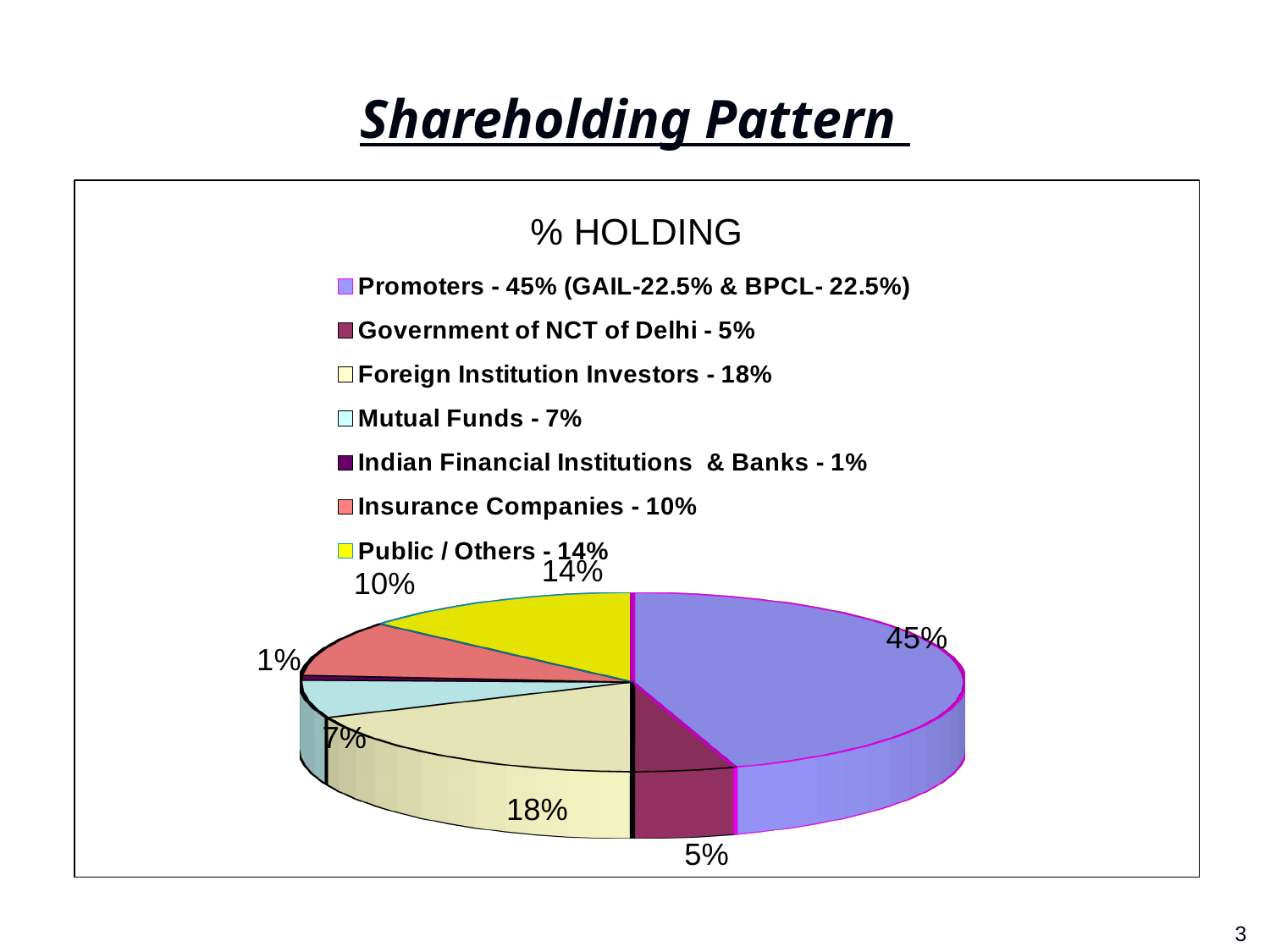
What kind of chart is shown on the slide? pie chart What is the holding of Government of NCT of Delhi? 5% Which is larger, the share of Public / Others or the share of Insurance Companies? Public / Others Which category has the largest share of the pie? Promoters What is the holding of Mutual Funds? 7% What percentage of holding do Promoters have? 45% What is the chart's title? % HOLDING What is the holding of Insurance Companies? 10% What is the difference between the Promoters' share and the Foreign Institution Investors' share? 27% Which category has the smallest share of the pie? Indian Financial Institutions & Banks What is the holding of Foreign Institution Investors? 18% How many categories does the legend list? 7